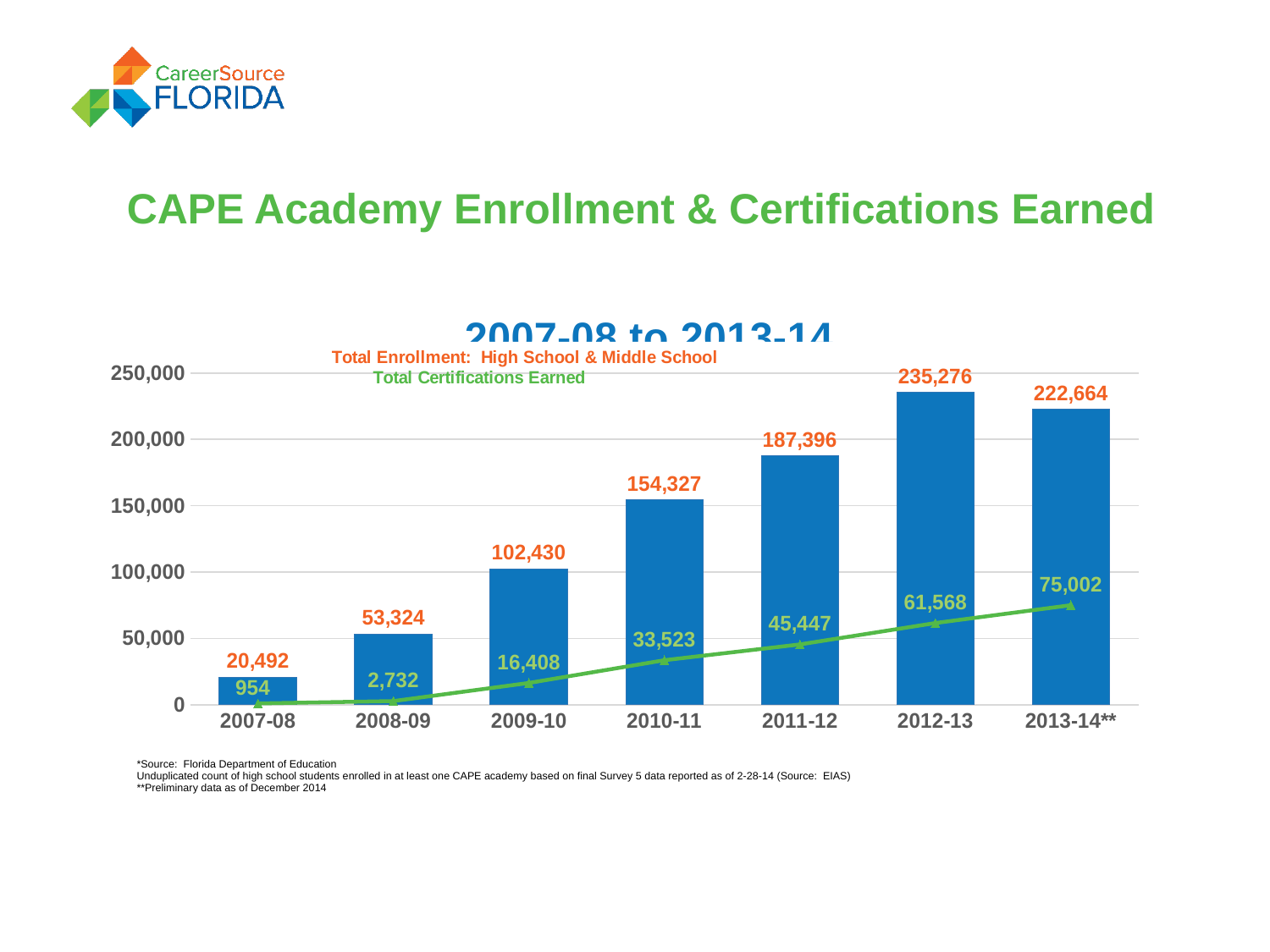
What was the Total Enrollment: High School & Middle School in 2012-13? 235,276 What is the difference in Total Enrollment between 2012-13 and 2013-14**? 12,612 Which school year has the lowest Total Certifications Earned? 2007-08 What was the Total Enrollment: High School & Middle School in 2007-08? 20,492 By how much did Total Certifications Earned increase from 2012-13 to 2013-14**? 13,434 Which is larger: Total Enrollment in 2009-10 or Total Enrollment in 2010-11? 2010-11 How many school years are shown on the x axis? 7 Does Total Certifications Earned rise or fall from 2007-08 to 2013-14**? rise How many data series does the chart show? 2 How many Total Certifications Earned are shown for 2010-11? 33,523 Which school year has the highest Total Enrollment: High School & Middle School? 2012-13 Is the Total Enrollment for 2011-12 greater or less than 200,000? less